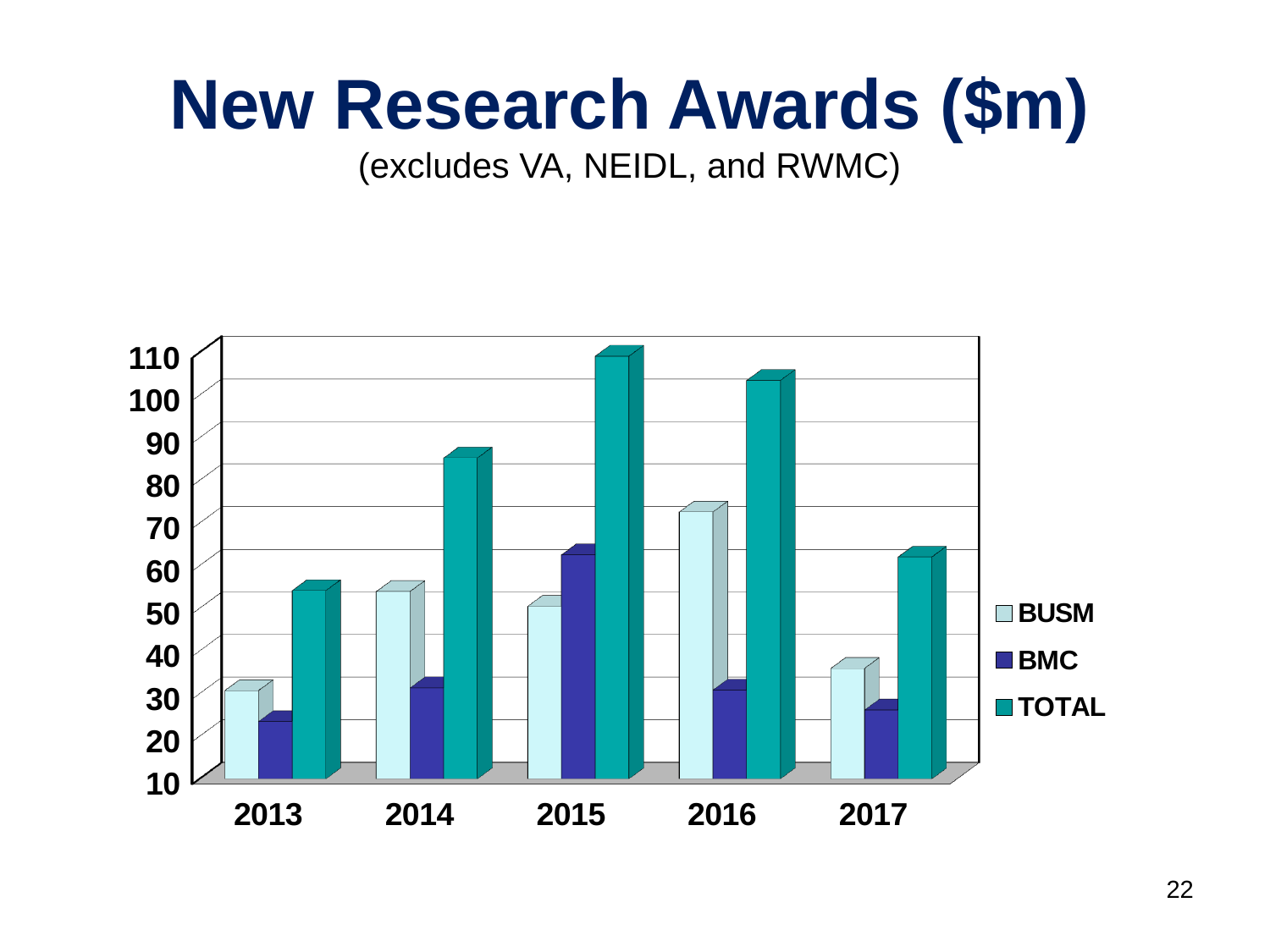
What kind of chart is shown on the slide? bar chart How many years are shown on the x axis? 5 Does the TOTAL value rise or fall from 2016 to 2017? fall In which year is the TOTAL bar highest? 2015 In which year is the BUSM bar highest? 2016 Is the TOTAL value for 2014 greater or less than 90? less In which year is the TOTAL bar lowest? 2013 Is the TOTAL value for 2015 greater or less than 100? greater In 2015, which is larger, BUSM or BMC? BMC How many series does the legend list? 3 In which year is the BMC bar highest? 2015 Is the BUSM value for 2013 greater or less than 40? less